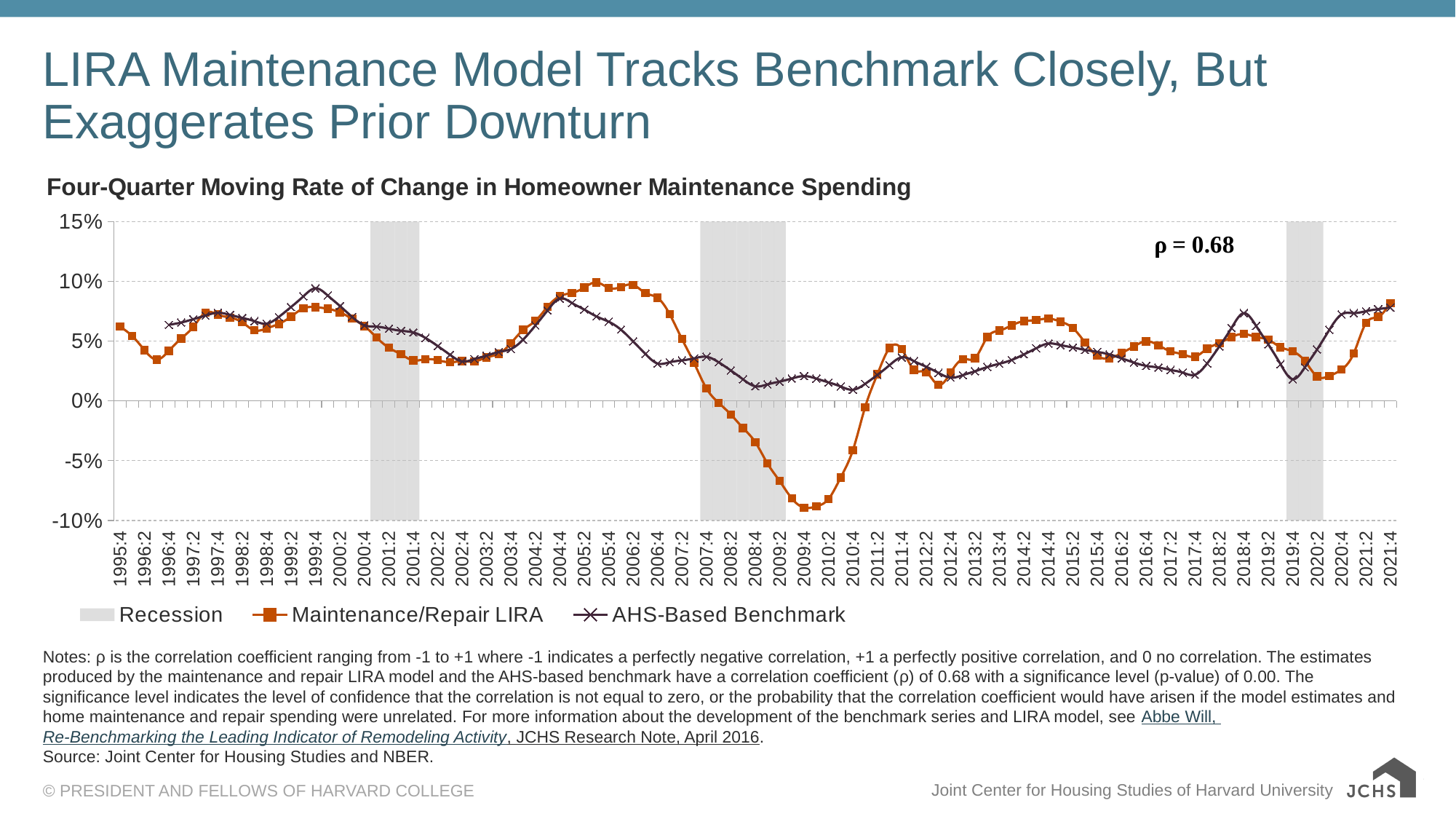
Is the value for AHS-Based Benchmark at 2009:4 greater or less than 0%? greater At 2009:4, which series has the higher value, Maintenance/Repair LIRA or AHS-Based Benchmark? AHS-Based Benchmark Is the value for Maintenance/Repair LIRA at 2009:4 greater or less than -5%? less At 2005:4, which series has the higher value, Maintenance/Repair LIRA or AHS-Based Benchmark? Maintenance/Repair LIRA Which series reaches the lowest value anywhere on the chart? Maintenance/Repair LIRA What kind of chart is shown on the slide? Line chart Does the Maintenance/Repair LIRA series rise or fall between 2007:4 and 2009:4? Fall Is the value for Maintenance/Repair LIRA at 2007:4 greater or less than 5%? less What correlation coefficient (ρ) is printed on the chart? ρ = 0.68 What is the title of the chart? Four-Quarter Moving Rate of Change in Homeowner Maintenance Spending How many entries does the chart legend list? 3